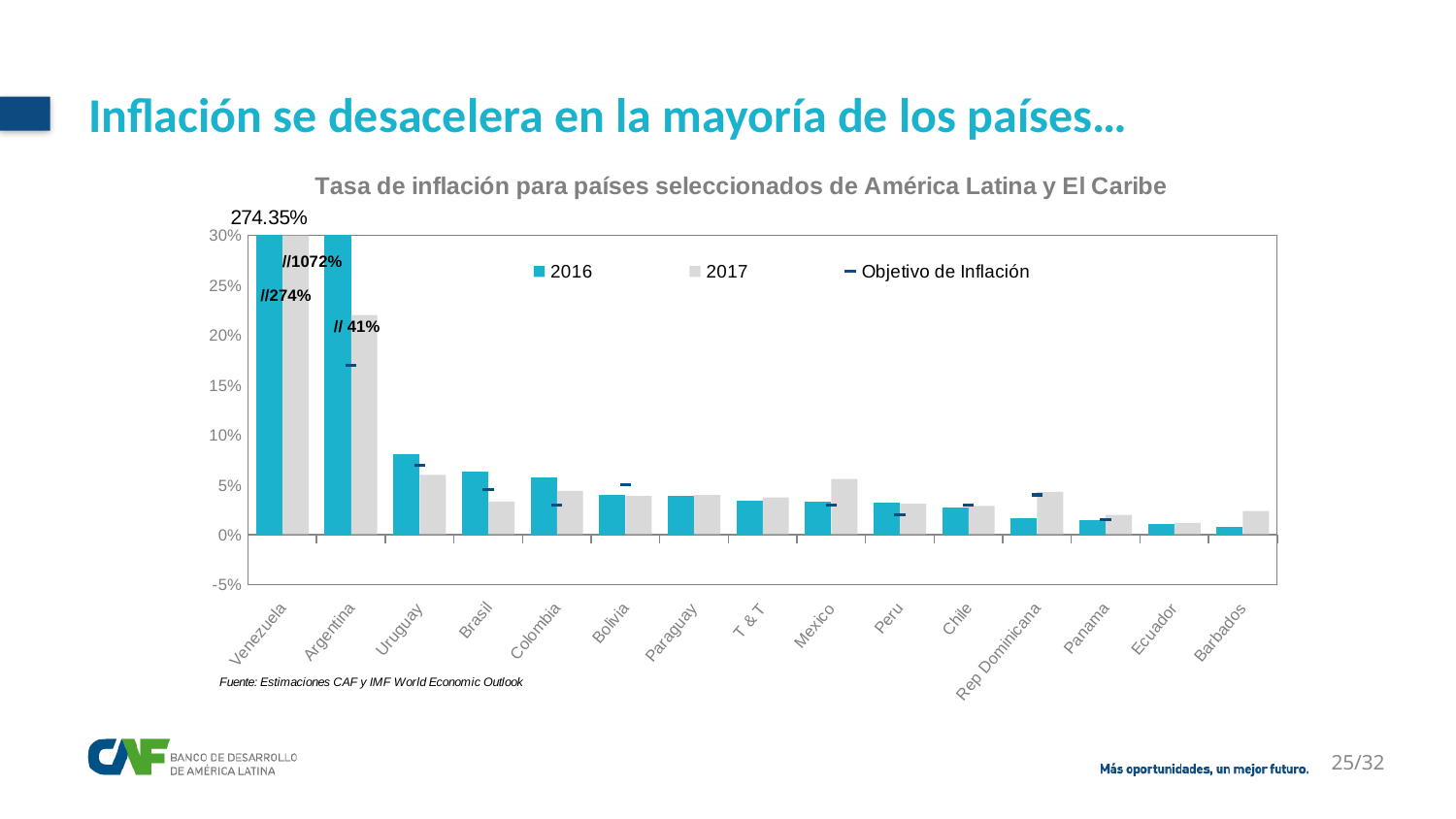
Which series in the legend is shown as a short horizontal line marker rather than a bar? Objetivo de Inflación Is the 2016 value for Uruguay greater or less than 5%? greater Is the 2017 value for Argentina greater or less than 20%? greater Which country has the highest 2016 inflation bar in the chart? Venezuela Which country has the lowest 2017 inflation bar in the chart? Ecuador How many countries are shown on the x axis of the chart? 15 How many series does the chart legend list? 3 Is the 2017 value for Brasil greater or less than 5%? less What kind of chart is shown on the slide? Bar chart For Mexico, which is larger: the 2016 bar or the 2017 bar? 2017 What is the title of the chart? Tasa de inflación para países seleccionados de América Latina y El Caribe For Uruguay, which is larger: the 2016 bar or the 2017 bar? 2016